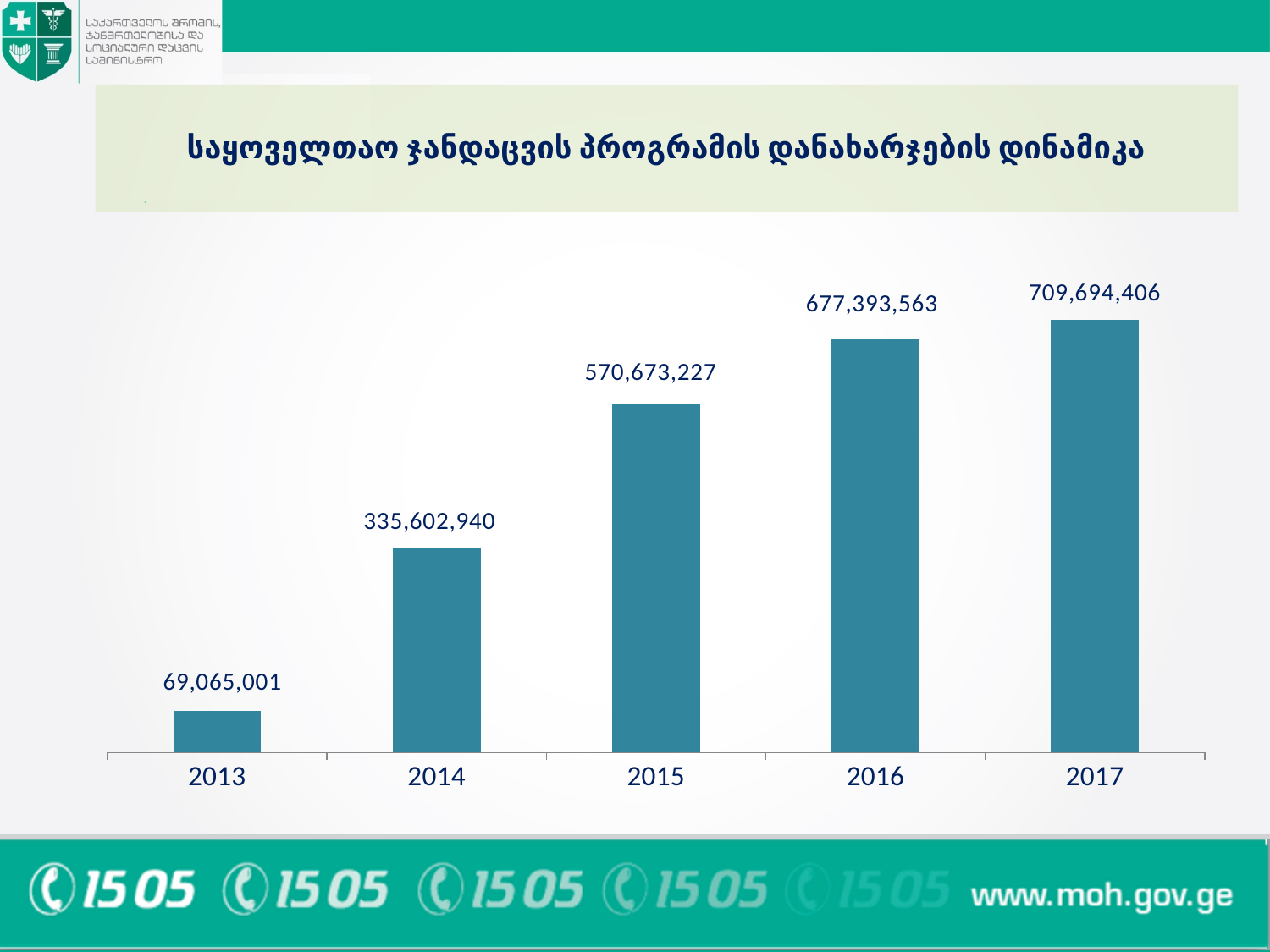
Which year has the lowest value? 2013 Which year has the highest value? 2017 What is the difference between the values for 2017 and 2016? 32,300,843 Which is larger, the value for 2015 or the value for 2016? 2016 How many years are shown on the x axis? 5 What is the value shown for 2013? 69,065,001 What is the difference between the values for 2014 and 2013? 266,537,939 What is the value shown for 2014? 335,602,940 What is the value shown for 2015? 570,673,227 What is the value shown for 2017? 709,694,406 What kind of chart is shown on the slide? Bar chart Do the values rise or fall from 2013 to 2017? Rise